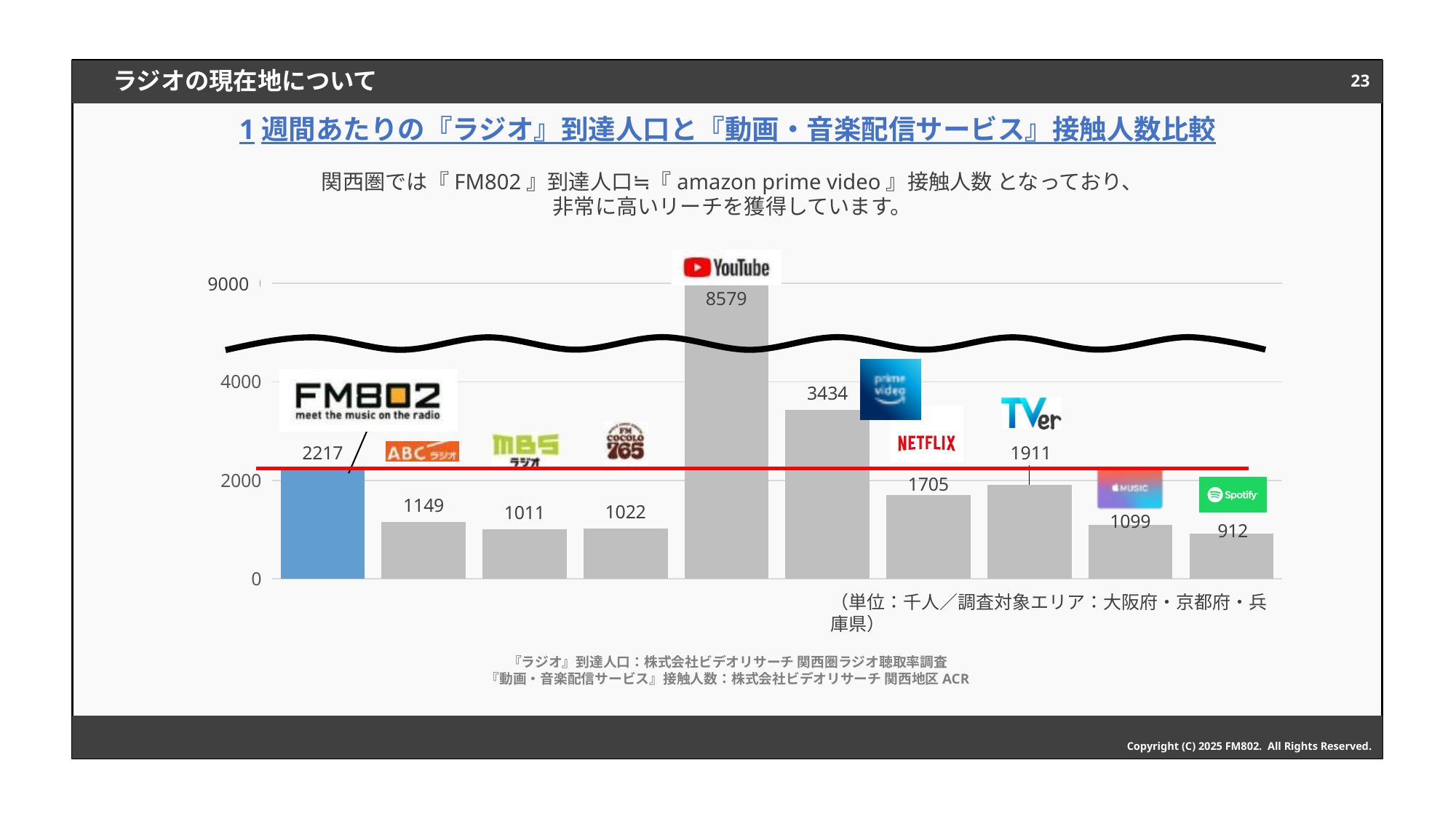
What is the value shown for prime video? 3434 How many bars are plotted in the chart? 10 What is the difference between the values for FM802 and TVer? 306 Which is larger, the value for ABC ラジオ or the value for MBS ラジオ? ABC ラジオ Which category has the lowest value? Spotify What is the value shown for YouTube? 8579 Which bar is coloured blue rather than grey? FM802 Which category has the highest value? YouTube What kind of chart is shown on the slide? Bar chart What is the value shown for NETFLIX? 1705 What is the value shown for Spotify? 912 What is the value shown for FM802? 2217